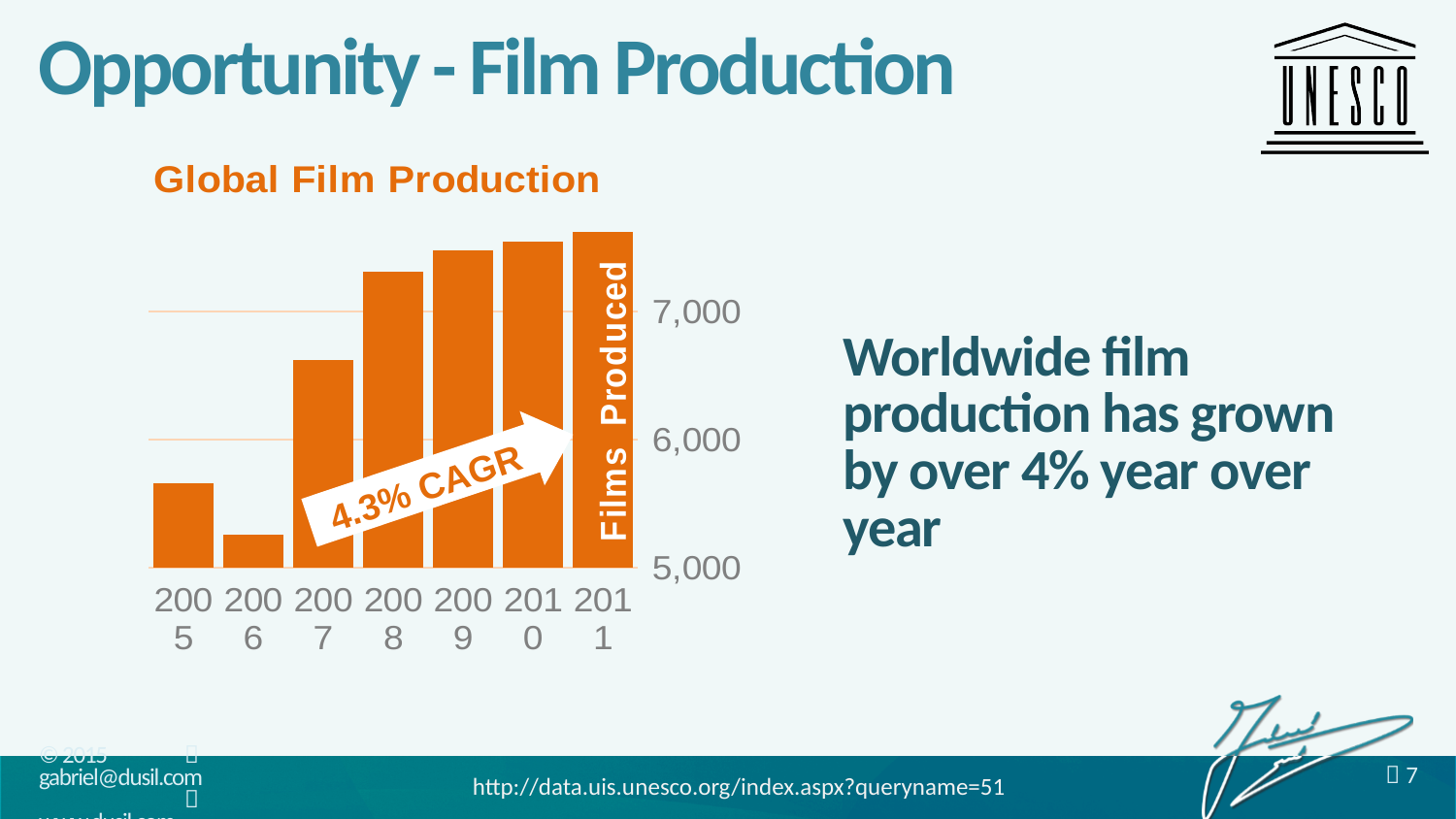
What is the title of the chart? Global Film Production Is the value for 2006 greater or less than 6,000? less Do the values rise or fall from 2006 to 2011? Rise What kind of chart is shown on the slide? Bar chart Which year has more films produced, 2006 or 2007? 2007 Is the value for 2008 greater or less than 7,000? greater What growth rate is annotated on the chart? 4.3% CAGR Is the value for 2005 greater or less than 6,000? less Which year has the lowest number of films produced? 2006 Which year has more films produced, 2005 or 2006? 2005 How many years are shown on the x axis of the Global Film Production chart? 7